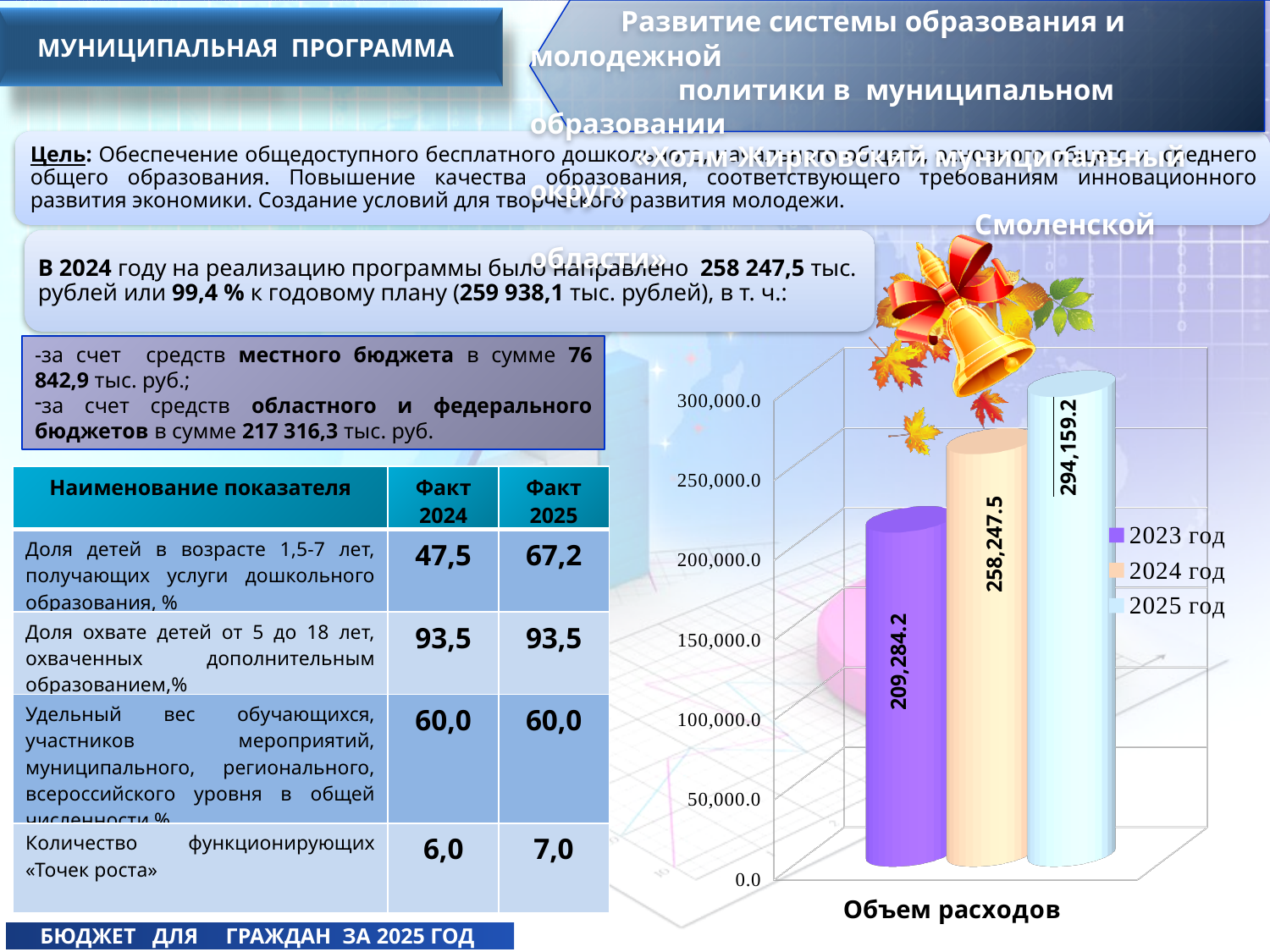
What is the value shown for 2025 год in the chart? 294,159.2 Is the value for 2023 год greater or less than 250,000.0? less What is the value shown for 2023 год in the chart? 209,284.2 What is the category label shown below the bars of the chart? Объем расходов What kind of chart is shown on the slide? bar chart What is the difference between the values for 2025 год and 2024 год? 35,911.7 Which year has the lowest value in the chart? 2023 год Which is larger, the value for 2023 год or the value for 2024 год? 2024 год How many series does the chart legend list? 3 What is the difference between the values for 2024 год and 2023 год? 48,963.3 What is the value shown for 2024 год in the chart? 258,247.5 Which year has the highest value in the chart? 2025 год